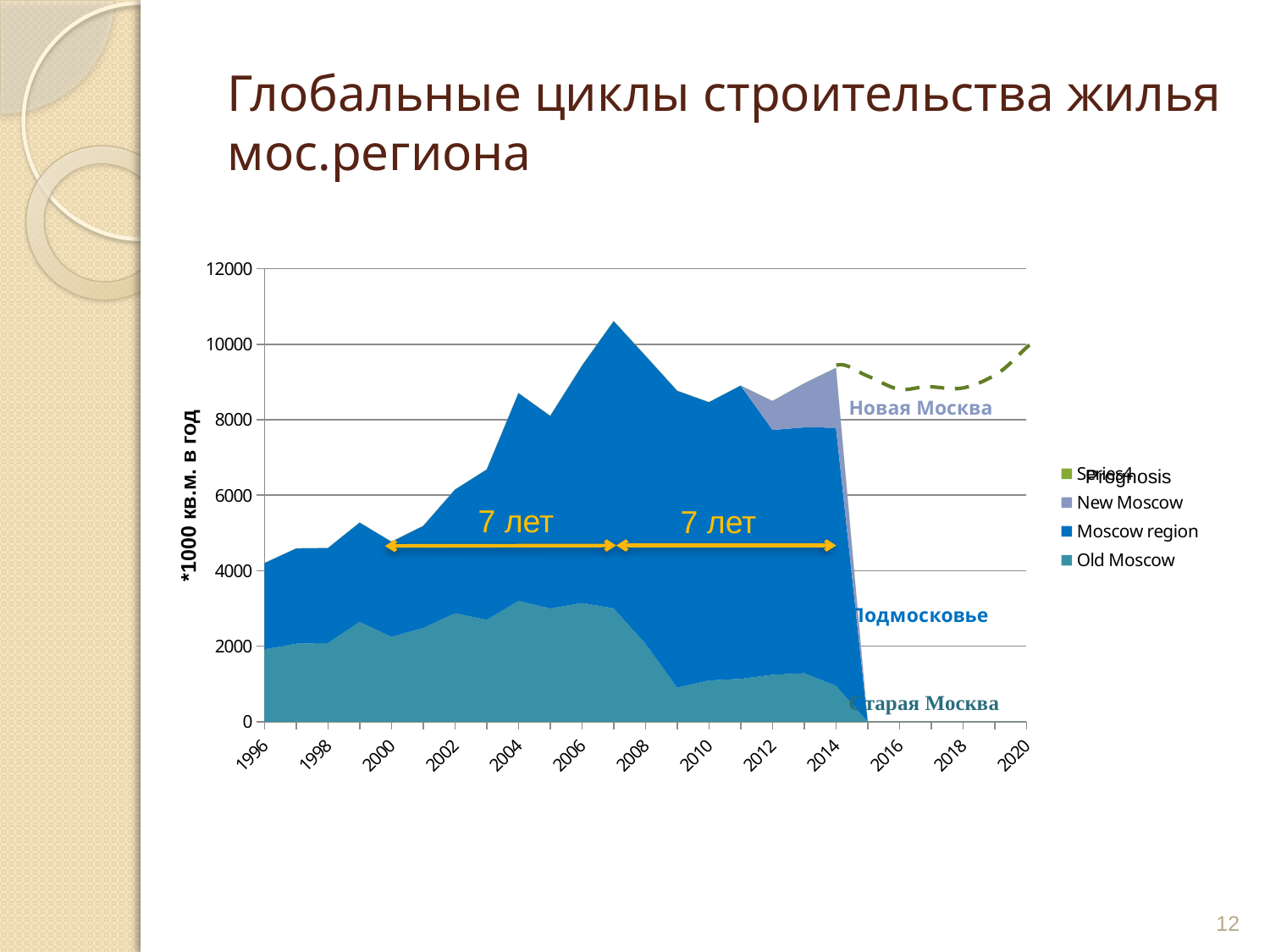
Is the Old Moscow value in 2004 greater or less than 2000? greater Which series in the legend is drawn in teal (the bottom area)? Old Moscow Is the total stacked value in 2000 greater or less than 6000? less In which year does the total stacked value reach its highest point? 2007 What kind of chart is shown on the slide? Stacked area chart Is the Old Moscow value in 2010 greater or less than 2000? less Does the total stacked value rise or fall between 2000 and 2007? rise Does the Old Moscow value rise or fall between 2008 and 2010? fall What is the label on the vertical axis of the chart? *1000 кв.м. в год How many year labels are shown along the x axis? 13